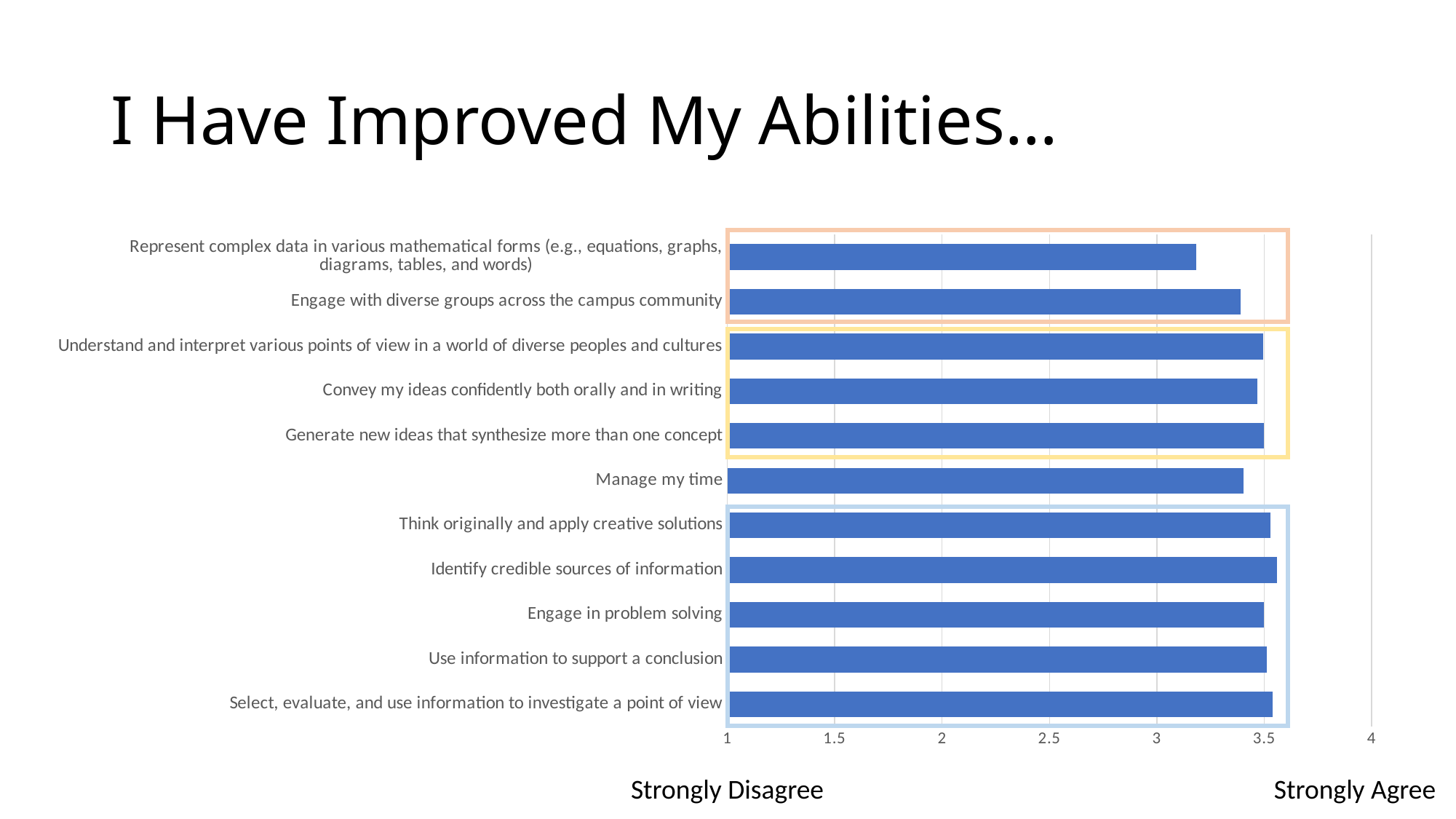
Which has the larger value: "Engage with diverse groups across the campus community" or "Represent complex data in various mathematical forms"? Engage with diverse groups across the campus community How many categories (abilities) are plotted in the chart? 11 Is the value for "Represent complex data in various mathematical forms" greater or less than 3.5? less Is the value for "Engage with diverse groups across the campus community" greater or less than 3? greater Is the value for "Manage my time" greater or less than 3.5? less What labels appear at the left and right ends of the horizontal axis below the chart? Strongly Disagree and Strongly Agree What is the title of the slide containing the chart? I Have Improved My Abilities… Which has the larger value: "Identify credible sources of information" or "Manage my time"? Identify credible sources of information Which category has the lowest value in the chart? Represent complex data in various mathematical forms (e.g., equations, graphs, diagrams, tables, and words) What kind of chart is shown on the slide? bar chart